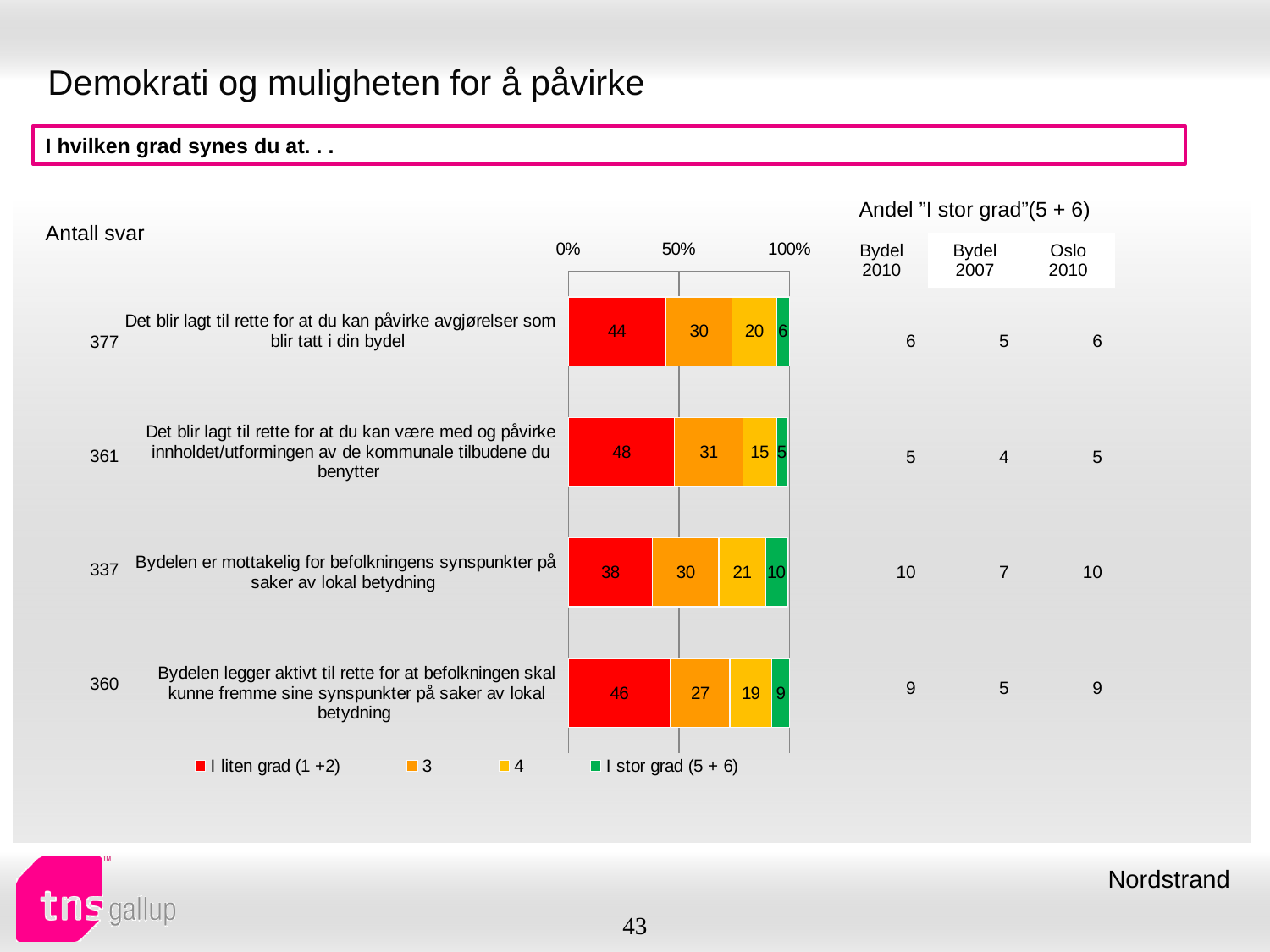
What kind of chart is shown on the slide? stacked bar chart What is the value of series "4" for "Det blir lagt til rette for at du kan være med og påvirke innholdet/utformingen av de kommunale tilbudene du benytter"? 15 Which is larger: the "I stor grad (5 + 6)" value for "Bydelen legger aktivt til rette for at befolkningen skal kunne fremme sine synspunkter på saker av lokal betydning" or for "Det blir lagt til rette for at du kan påvirke avgjørelser som blir tatt i din bydel"? Bydelen legger aktivt til rette for at befolkningen skal kunne fremme sine synspunkter på saker av lokal betydning How many series does the chart legend list? 4 Which statement has the lowest value for "I stor grad (5 + 6)"? Det blir lagt til rette for at du kan være med og påvirke innholdet/utformingen av de kommunale tilbudene du benytter What is the value of "I liten grad (1 +2)" for "Det blir lagt til rette for at du kan påvirke avgjørelser som blir tatt i din bydel"? 44 How many categories (statements) are plotted in the chart? 4 Which statement has the highest value for "I liten grad (1 +2)"? Det blir lagt til rette for at du kan være med og påvirke innholdet/utformingen av de kommunale tilbudene du benytter What is the value of "I stor grad (5 + 6)" for "Bydelen er mottakelig for befolkningens synspunkter på saker av lokal betydning"? 10 What is the total of the stacked bar for "Det blir lagt til rette for at du kan påvirke avgjørelser som blir tatt i din bydel"? 100 What is the difference between the "I liten grad (1 +2)" values for "Det blir lagt til rette for at du kan være med og påvirke innholdet/utformingen av de kommunale tilbudene du benytter" and "Bydelen er mottakelig for befolkningens synspunkter på saker av lokal betydning"? 10 What is the value of series "3" for "Bydelen legger aktivt til rette for at befolkningen skal kunne fremme sine synspunkter på saker av lokal betydning"? 27